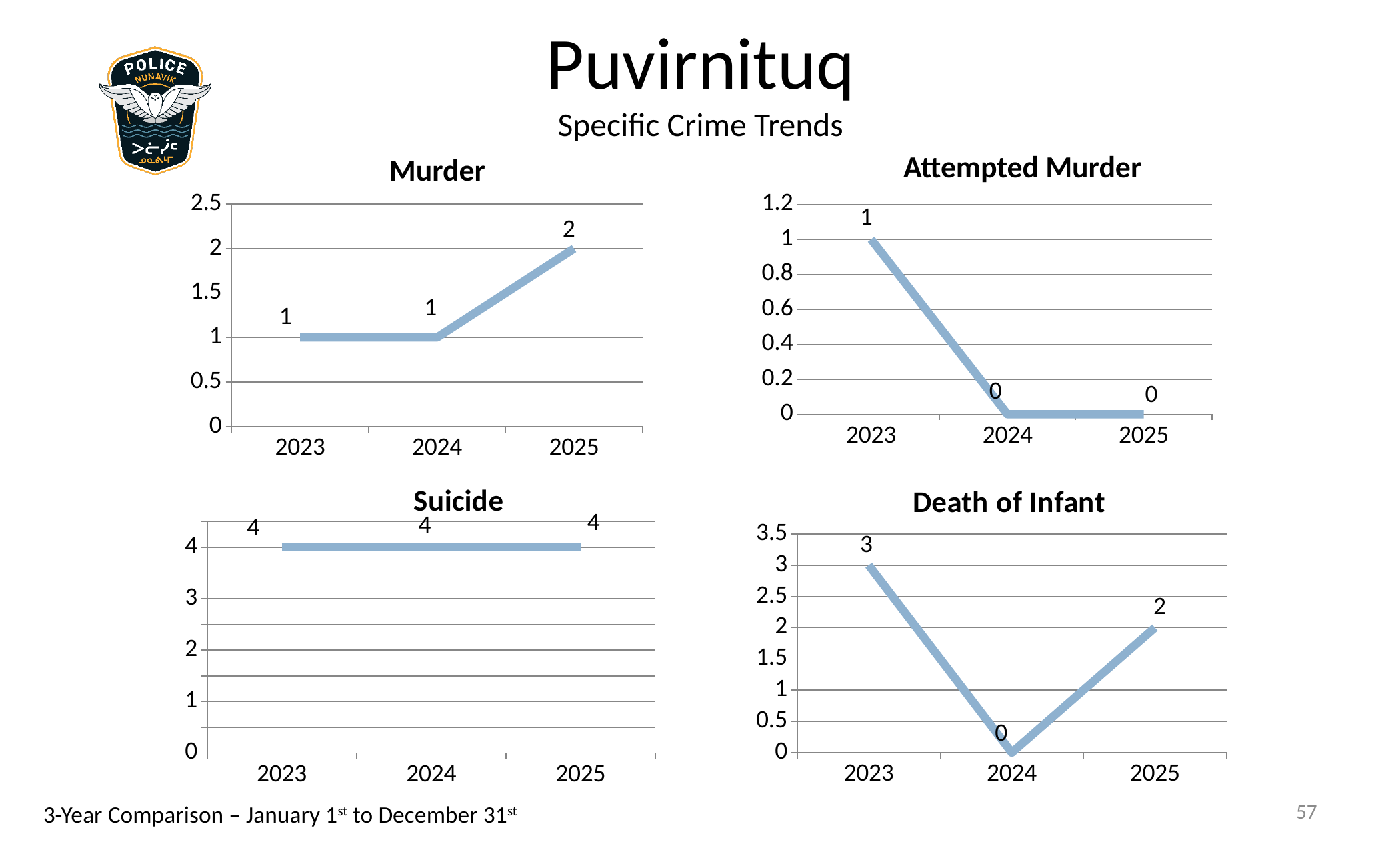
What kind of chart is the Murder chart? line chart In the Death of Infant chart, which is larger, the value for 2023 or the value for 2025? 2023 In the Attempted Murder chart, what is the difference between the 2023 value and the 2024 value? 1 In the Death of Infant chart, what is the value for 2023? 3 In the Suicide chart, what is the value for 2024? 4 In the Suicide chart, do the values rise, fall, or stay flat from 2023 to 2025? stay flat In the Murder chart, which year has the highest value? 2025 In the Murder chart, what is the value for 2025? 2 In the Death of Infant chart, which year has the lowest value? 2024 In the Attempted Murder chart, what is the value for 2023? 1 In the Death of Infant chart, what is the difference between the 2023 value and the 2025 value? 1 How many years are plotted in the Attempted Murder chart? 3